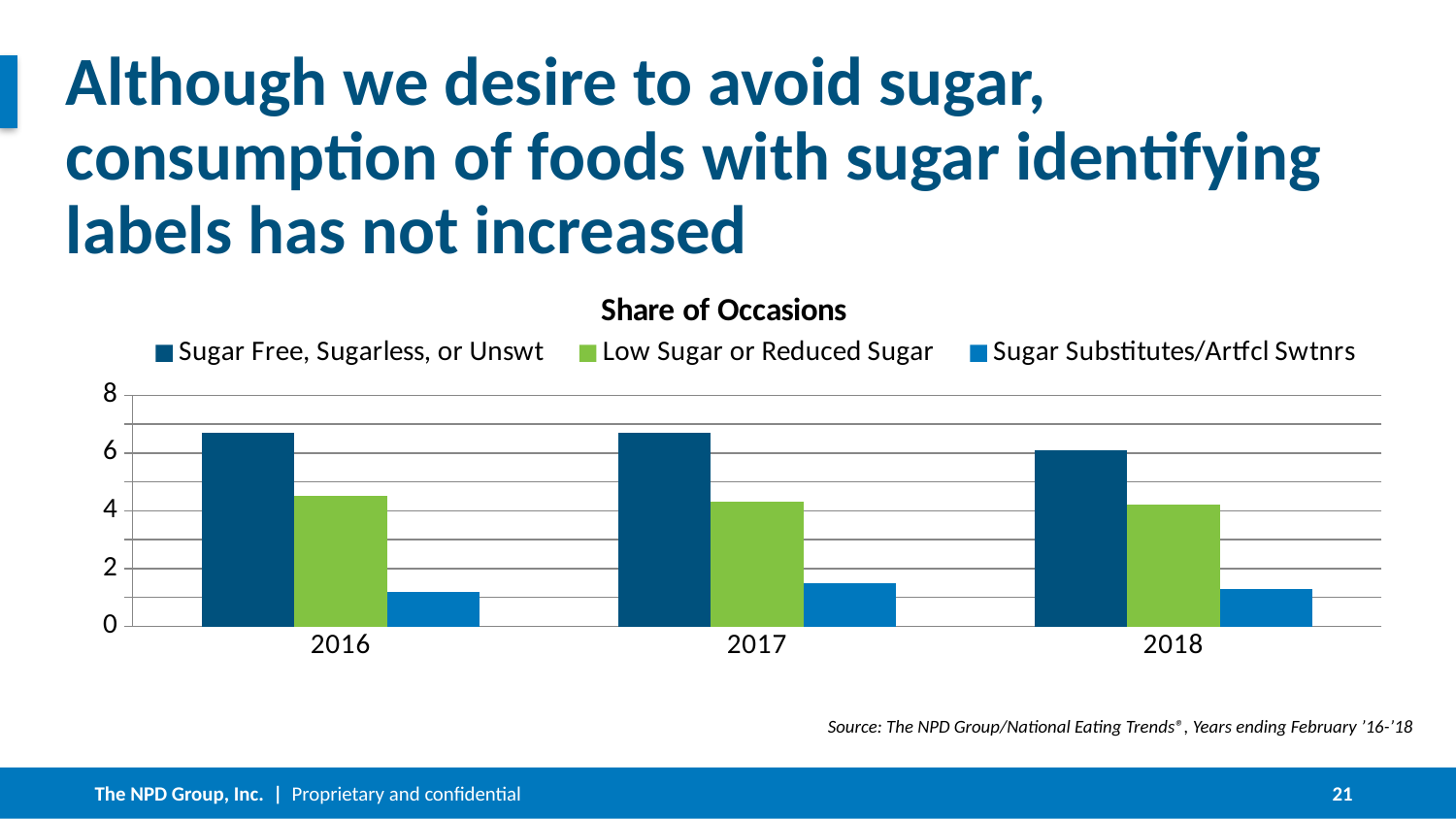
How many years are shown on the x axis? 3 How many series does the legend list? 3 Which series has the highest value in 2018? Sugar Free, Sugarless, or Unswt Is the value for Low Sugar or Reduced Sugar in 2016 greater or less than 4? greater Is the value for Low Sugar or Reduced Sugar in 2018 greater or less than 6? less Is the value for Sugar Free, Sugarless, or Unswt in 2016 greater or less than 6? greater Which series is shown in green in the legend? Low Sugar or Reduced Sugar In 2017, which is larger: Sugar Free, Sugarless, or Unswt or Low Sugar or Reduced Sugar? Sugar Free, Sugarless, or Unswt Which series has the lowest value in 2016? Sugar Substitutes/Artfcl Swtnrs What kind of chart is shown on the slide? Bar chart What is the title of the chart? Share of Occasions